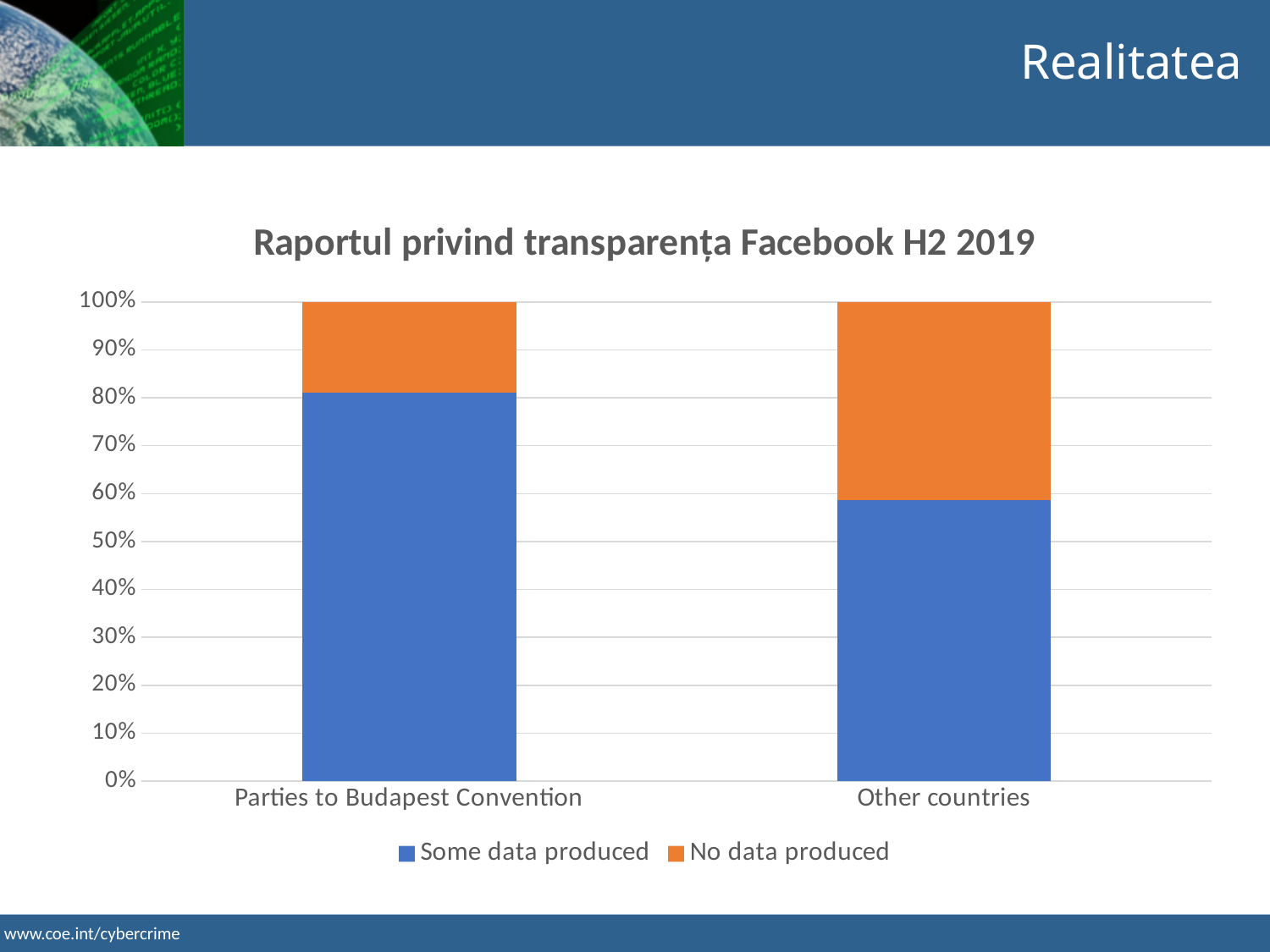
How many categories are shown on the x axis? 2 Which series is shown in orange? No data produced Which category has the larger 'No data produced' share? Other countries How many series does the legend list? 2 Is the 'No data produced' share for Other countries greater or less than 40%? greater Which category has the higher 'Some data produced' share? Parties to Budapest Convention What is the total height of the stacked bar for Other countries? 100% What is the title of the chart? Raportul privind transparența Facebook H2 2019 Is the 'Some data produced' value for Other countries greater or less than 60%? less What kind of chart is shown on the slide? Stacked bar chart